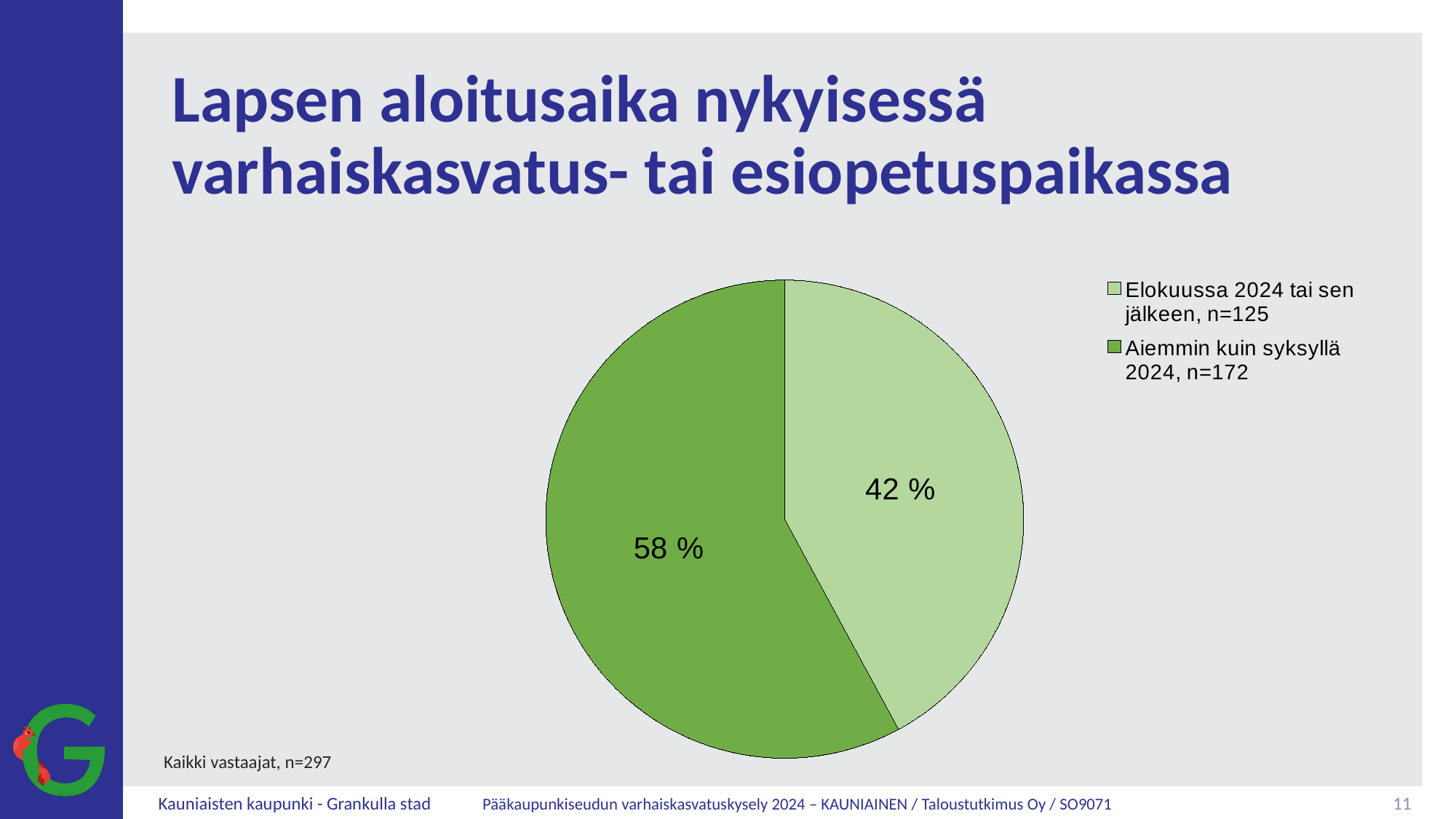
Is the share for "Elokuussa 2024 tai sen jälkeen" greater or less than 50 %? less What colour is the slice for "Aiemmin kuin syksyllä 2024, n=172"? dark green What share of the pie does "Elokuussa 2024 tai sen jälkeen, n=125" represent? 42 % What is the difference in percentage points between the "Aiemmin kuin syksyllä 2024" slice and the "Elokuussa 2024 tai sen jälkeen" slice? 16 percentage points What kind of chart is shown on the slide? pie chart How many slices does the pie chart have? 2 What share of the pie does "Aiemmin kuin syksyllä 2024, n=172" represent? 58 % What is the total number of respondents (n) stated on the slide? n=297 Which slice of the pie is the smallest? Elokuussa 2024 tai sen jälkeen, n=125 Which is larger: the share for "Elokuussa 2024 tai sen jälkeen" or the share for "Aiemmin kuin syksyllä 2024"? Aiemmin kuin syksyllä 2024 How many entries does the legend list? 2 Which slice of the pie is the largest? Aiemmin kuin syksyllä 2024, n=172